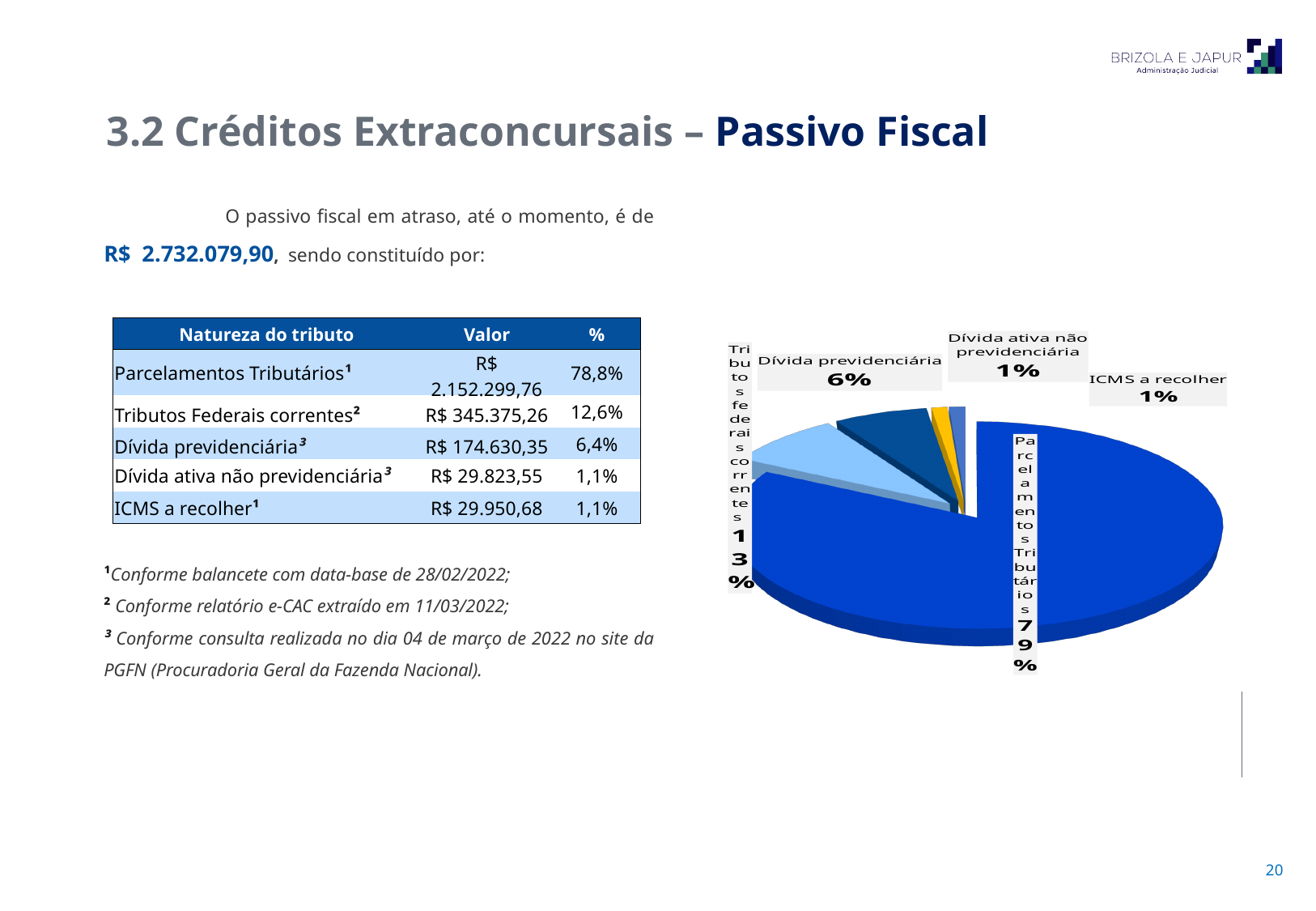
What percentage is shown for Tributos federais correntes in the pie chart? 13% What is the difference in percentage points between the Dívida previdenciária slice and the ICMS a recolher slice in the pie chart? 5 Which slice of the pie chart is the largest? Parcelamentos Tributários What kind of chart is shown on the slide? pie chart What percentage is shown for Dívida ativa não previdenciária in the pie chart? 1% What percentage is shown for ICMS a recolher in the pie chart? 1% What colour is the Parcelamentos Tributários slice in the pie chart? blue In the pie chart, which is larger: Tributos federais correntes or Dívida previdenciária? Tributos federais correntes What percentage is shown for Dívida previdenciária in the pie chart? 6% How many slices does the pie chart have? 5 What share of the pie chart does Parcelamentos Tributários represent? 79% What is the difference in percentage points between the Parcelamentos Tributários slice and the Tributos federais correntes slice in the pie chart? 66